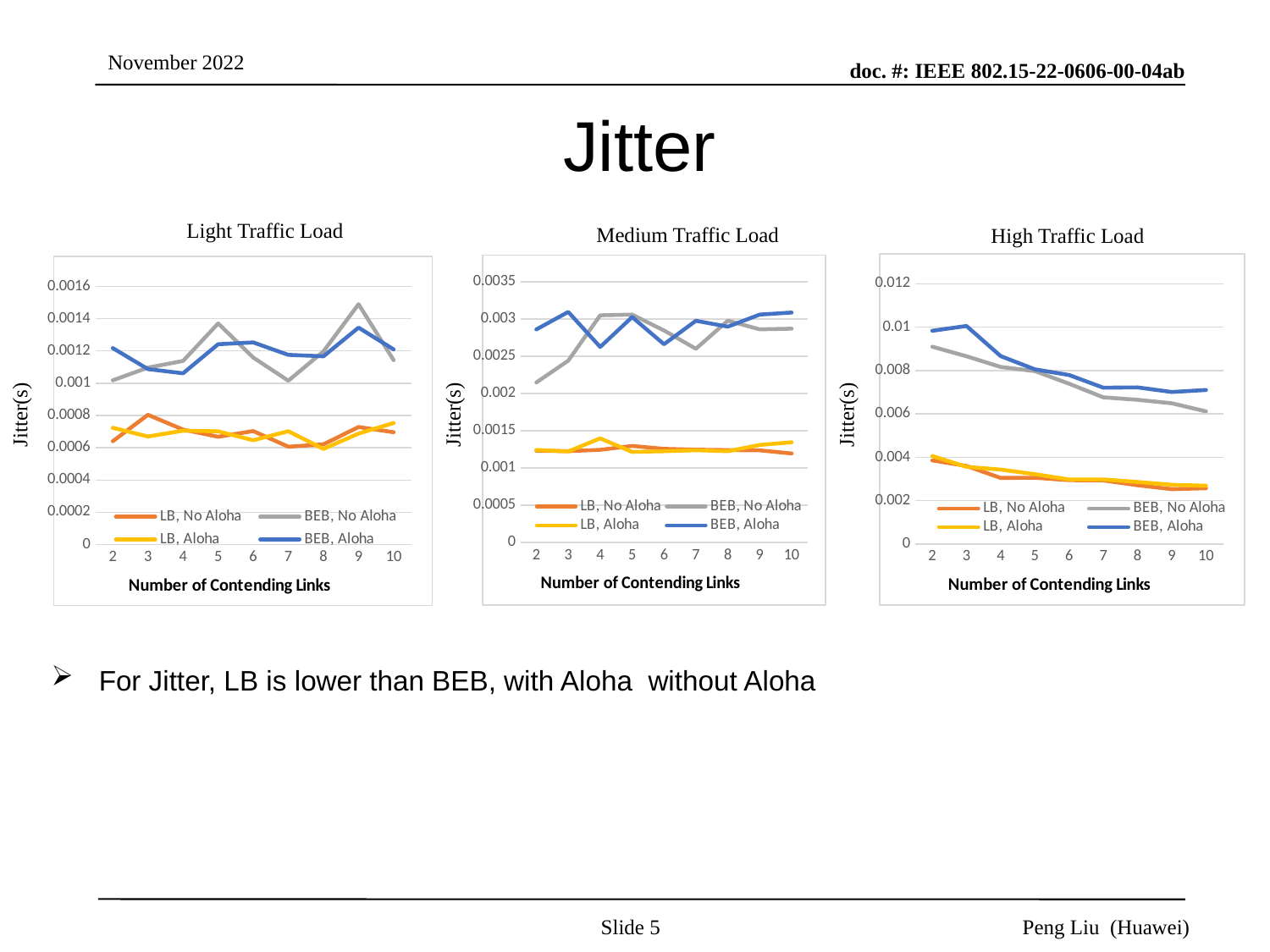
In the Light Traffic Load chart, which series has the highest value at 9 contending links? BEB, No Aloha In the High Traffic Load chart, does the BEB, Aloha series rise or fall from 2 to 10 contending links? fall How many series does the legend of the Medium Traffic Load chart list? 4 What is the x-axis title of the High Traffic Load chart? Number of Contending Links In the Medium Traffic Load chart, is the value for BEB, No Aloha at 2 contending links greater or less than 0.0025? less In the Light Traffic Load chart, at 9 contending links, which is larger: BEB, No Aloha or LB, Aloha? BEB, No Aloha In the Medium Traffic Load chart, does the BEB, No Aloha series rise or fall from 2 to 5 contending links? rise In the Medium Traffic Load chart, is the value for LB, No Aloha at 10 contending links greater or less than 0.0015? less What kind of chart is the Light Traffic Load chart? line chart How many x-axis points (numbers of contending links) are plotted in the High Traffic Load chart? 9 In the Light Traffic Load chart, is the value for BEB, No Aloha at 9 contending links greater or less than 0.0014? greater